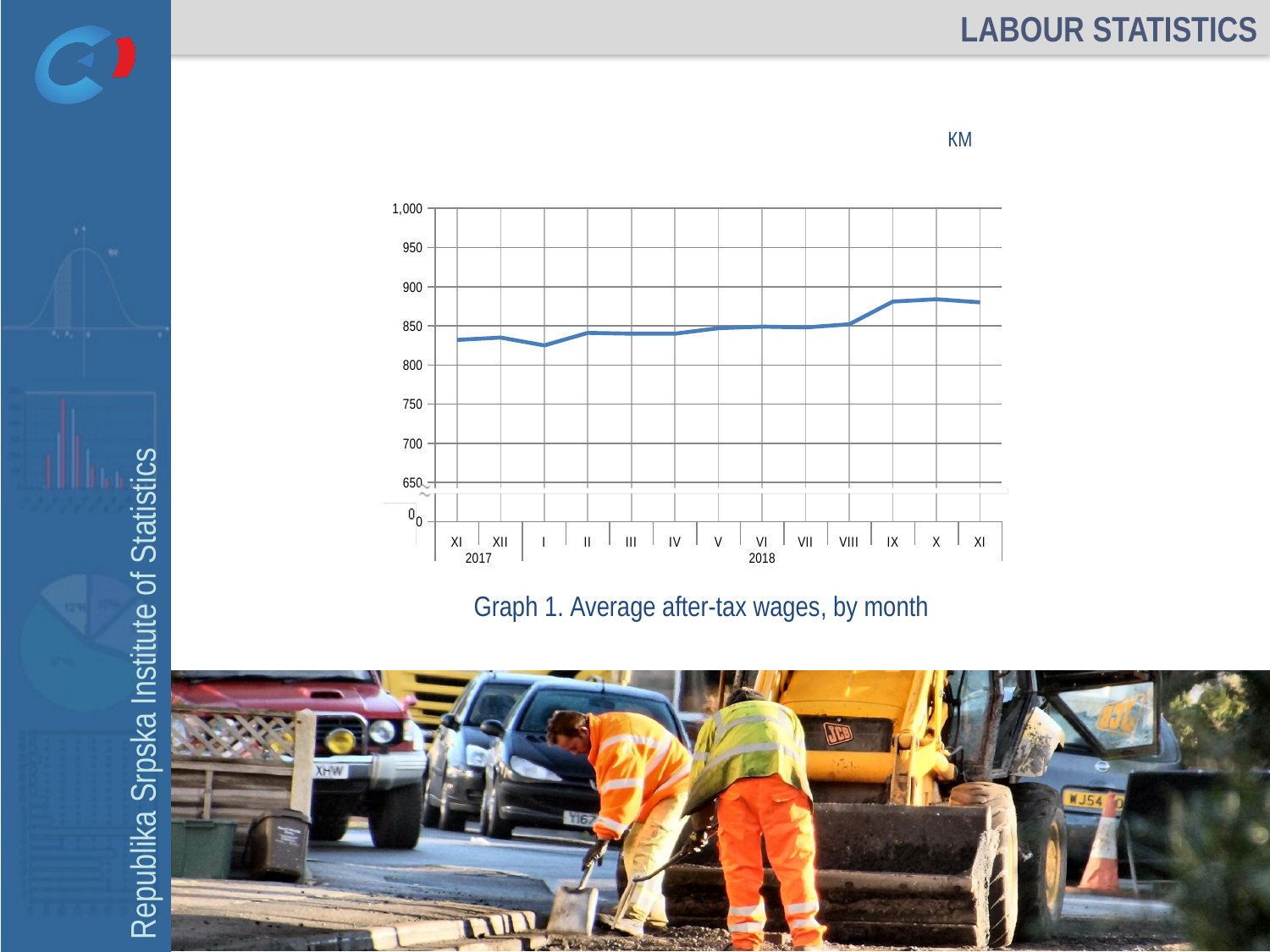
Which month has the lowest average after-tax wage on the chart? I 2018 Do the average after-tax wages generally rise or fall from XI 2017 to XI 2018? rise Is the value for X 2018 greater or less than 850? greater How many monthly data points are plotted on the chart? 13 Which is larger, the value for IX 2018 or the value for I 2018? IX 2018 What kind of chart is shown on the slide? line chart What unit is indicated above the chart? KM Is the value for XI 2018 greater or less than 850? greater Is the value for IX 2018 greater or less than 900? less What is the title of the chart? Graph 1. Average after-tax wages, by month